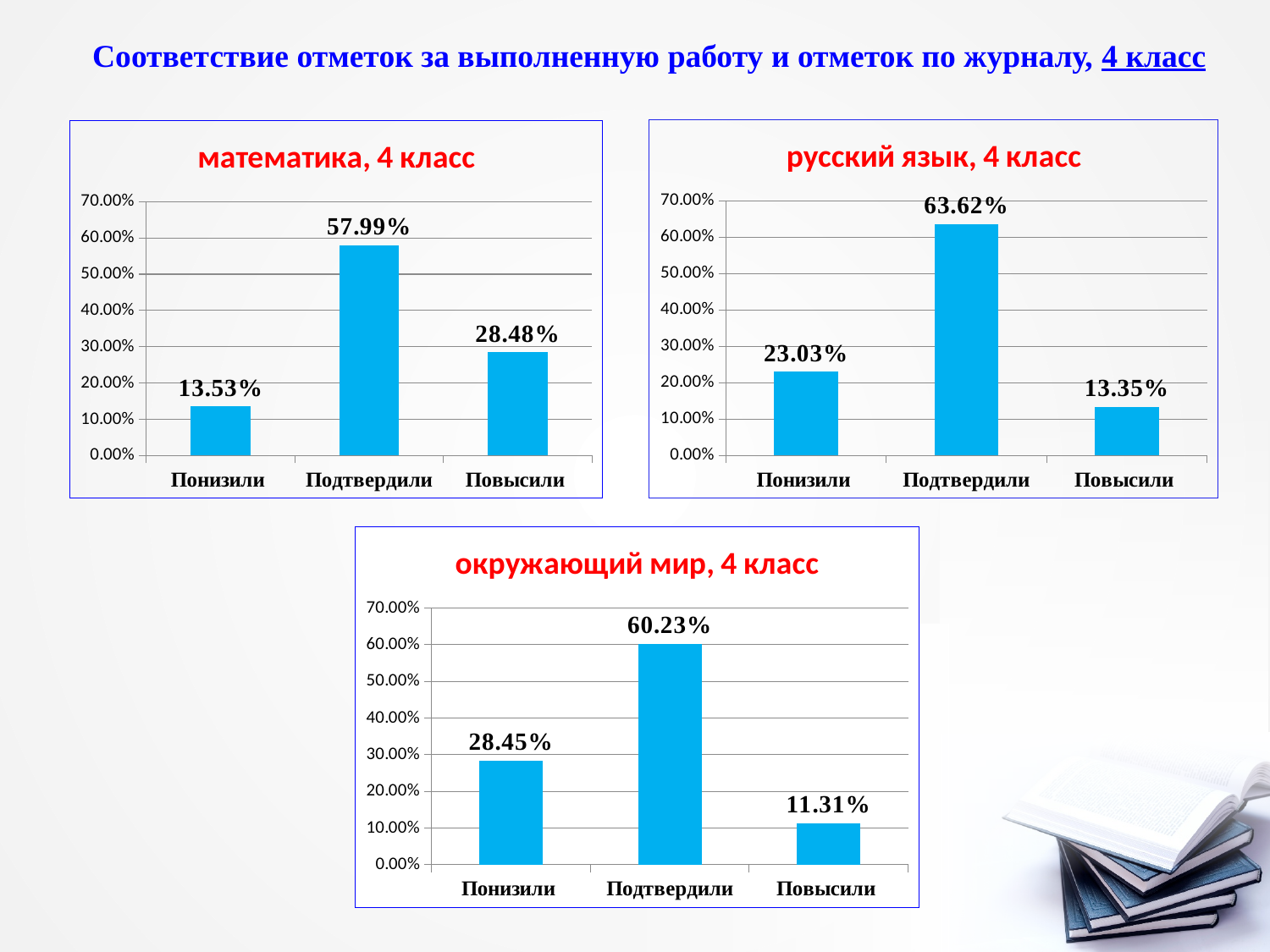
In the chart titled "русский язык, 4 класс", what is the difference between Понизили and Повысили? 9.68% In the chart titled "окружающий мир, 4 класс", what is the difference between Подтвердили and Понизили? 31.78% In the chart titled "математика, 4 класс", what is the value for Подтвердили? 57.99% In the chart titled "русский язык, 4 класс", what is the value for Понизили? 23.03% In the chart titled "окружающий мир, 4 класс", what is the value for Повысили? 11.31% What kind of chart is the chart titled "математика, 4 класс"? Bar chart In the chart titled "русский язык, 4 класс", is the value for Подтвердили greater or less than 60.00%? greater In the chart titled "русский язык, 4 класс", which category has the highest value? Подтвердили In the chart titled "математика, 4 класс", which category has the lowest value? Понизили How many categories are shown in the chart titled "окружающий мир, 4 класс"? 3 In the chart titled "математика, 4 класс", which is larger, Повысили or Понизили? Повысили How many charts are shown on the slide? 3